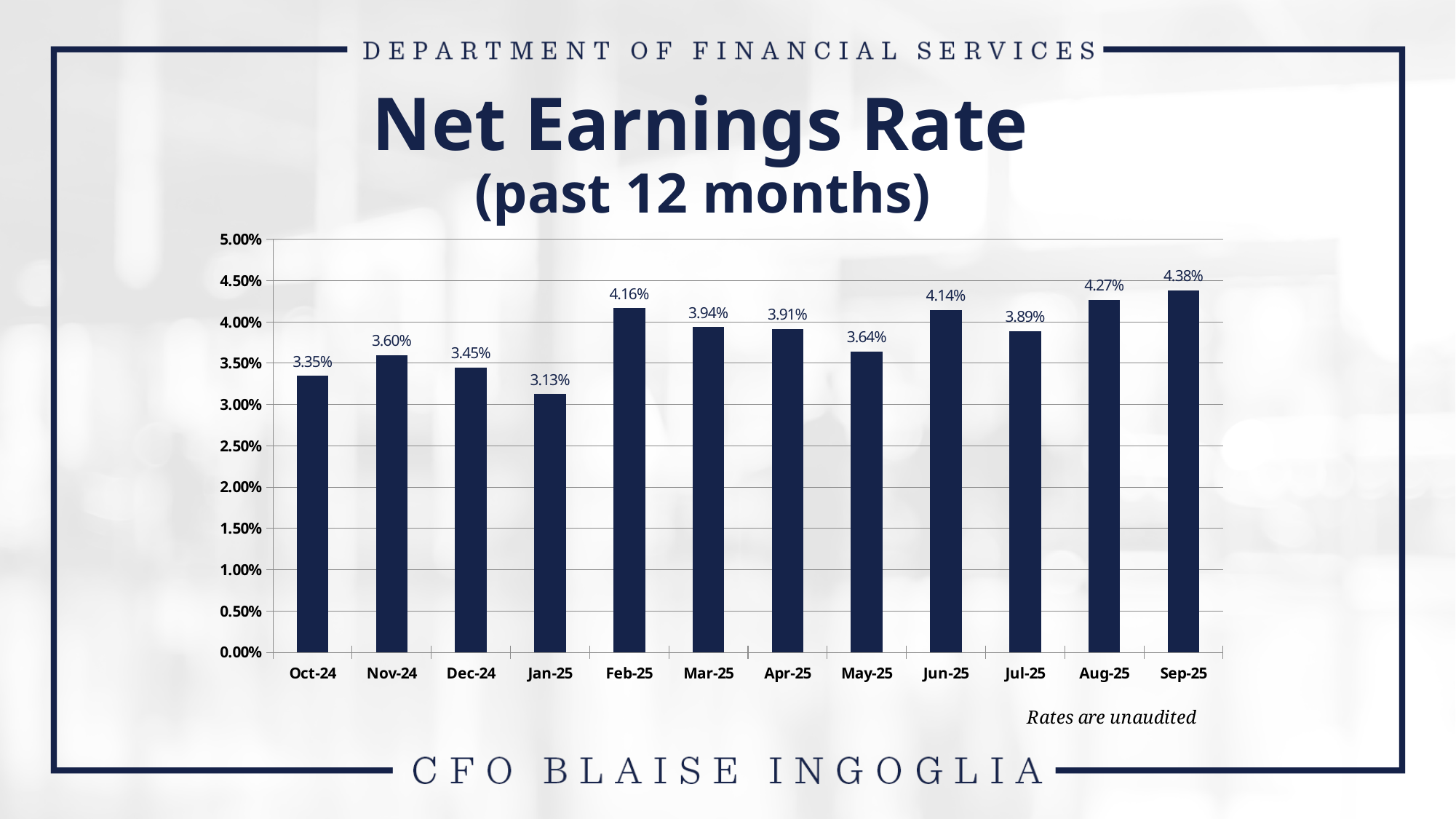
What is the title of the chart? Net Earnings Rate (past 12 months) What is the difference between the net earnings rate for Feb-25 and Jan-25? 1.03% What is the net earnings rate for Feb-25? 4.16% What is the net earnings rate for Jan-25? 3.13% How many months are shown on the chart? 12 What kind of chart is shown on the slide? Bar chart What is the difference between the net earnings rate for Sep-25 and Oct-24? 1.03% Which month has the highest net earnings rate? Sep-25 What is the net earnings rate for Jul-25? 3.89% Which month has the lowest net earnings rate? Jan-25 Is the net earnings rate for May-25 greater or less than 4.00%? less Which is larger, the net earnings rate for Nov-24 or Dec-24? Nov-24